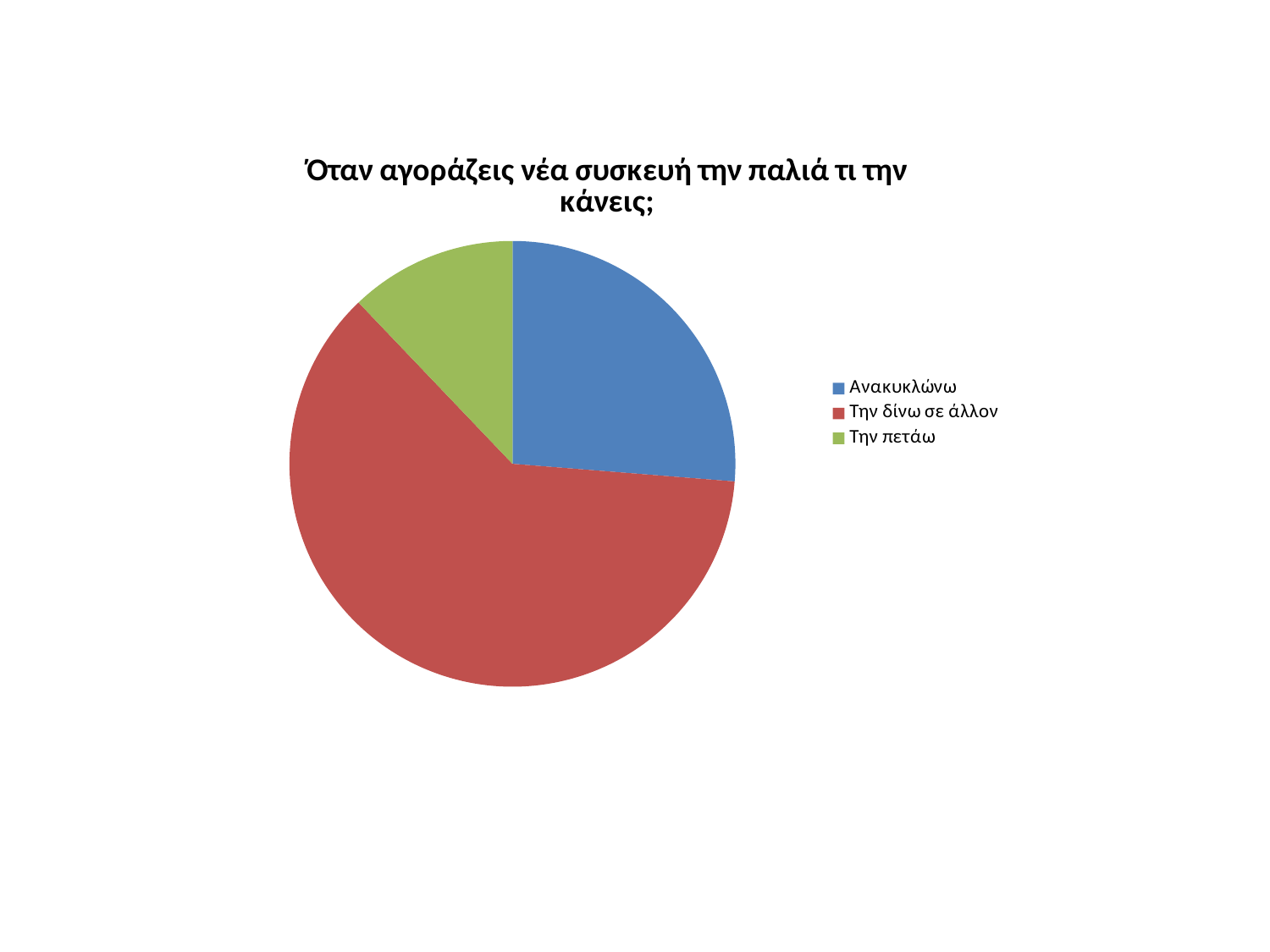
How many entries does the legend list? 3 Which category has the smallest slice of the pie? Την πετάω Does the slice for Την δίνω σε άλλον take up more or less than half of the pie? more What is the title of the chart? Όταν αγοράζεις νέα συσκευή την παλιά τι την κάνεις; Which slice is larger, Την δίνω σε άλλον or Ανακυκλώνω? Την δίνω σε άλλον What kind of chart is shown on the slide? pie chart Which slice is larger, Ανακυκλώνω or Την πετάω? Ανακυκλώνω Which colour represents Την δίνω σε άλλον in the pie chart? red How many slices does the pie chart have? 3 Which category has the largest slice of the pie? Την δίνω σε άλλον